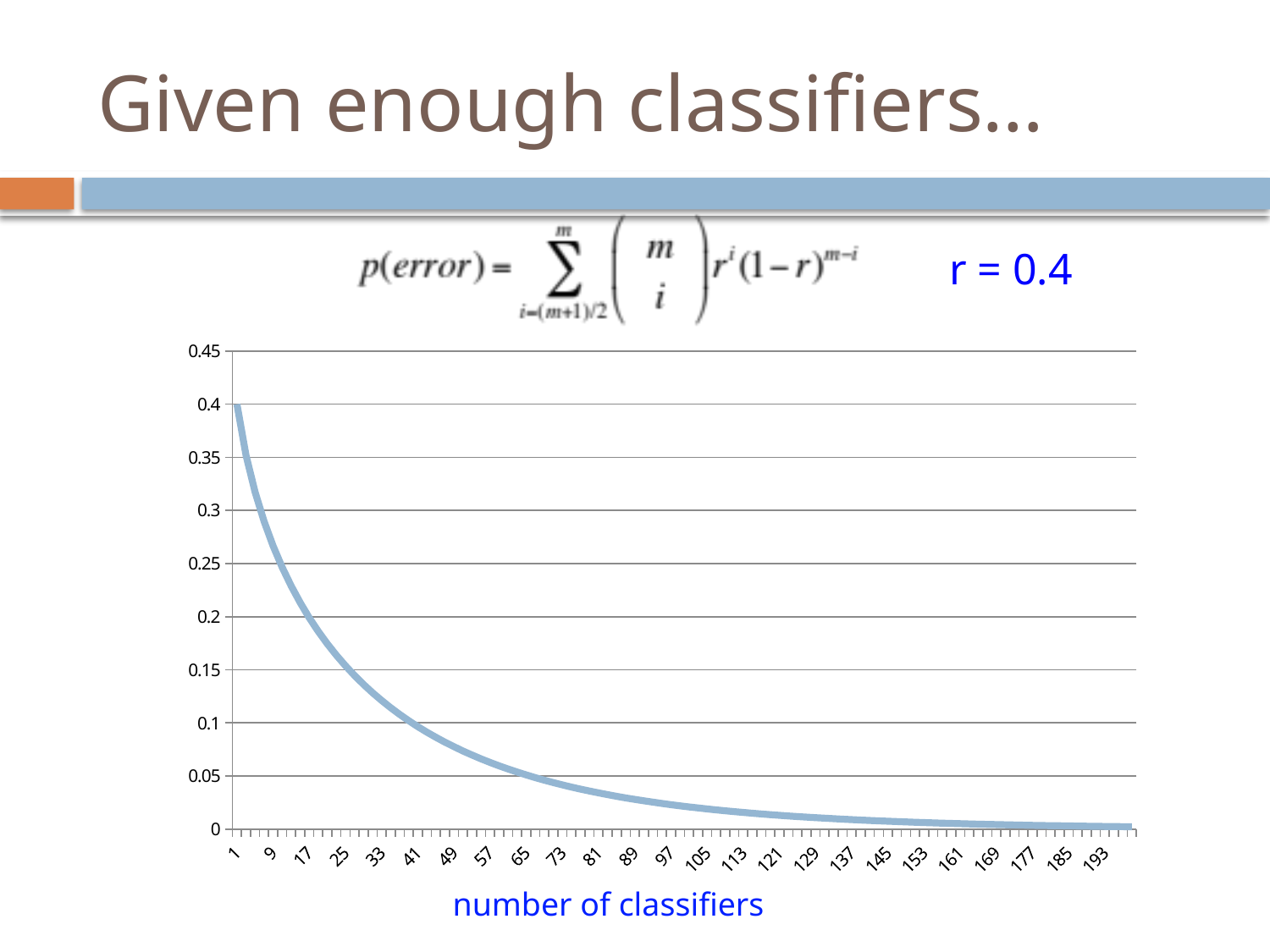
What is the label of the x axis? number of classifiers Is the value of p(error) at 97 classifiers greater or less than 0.05? less At which labelled number of classifiers is p(error) lowest? 193 What kind of chart is shown on the slide? line chart Does p(error) rise or fall as the number of classifiers increases? fall At which number of classifiers is p(error) highest? 1 What value of r is stated for the plotted curve? r = 0.4 Is the value of p(error) at 33 classifiers greater or less than 0.2? less How many tick labels are shown on the x axis? 25 Which is larger: p(error) at 9 classifiers or at 57 classifiers? 9 classifiers Is the value of p(error) at 9 classifiers greater or less than 0.25? greater What is the value of p(error) when the number of classifiers is 1? 0.4